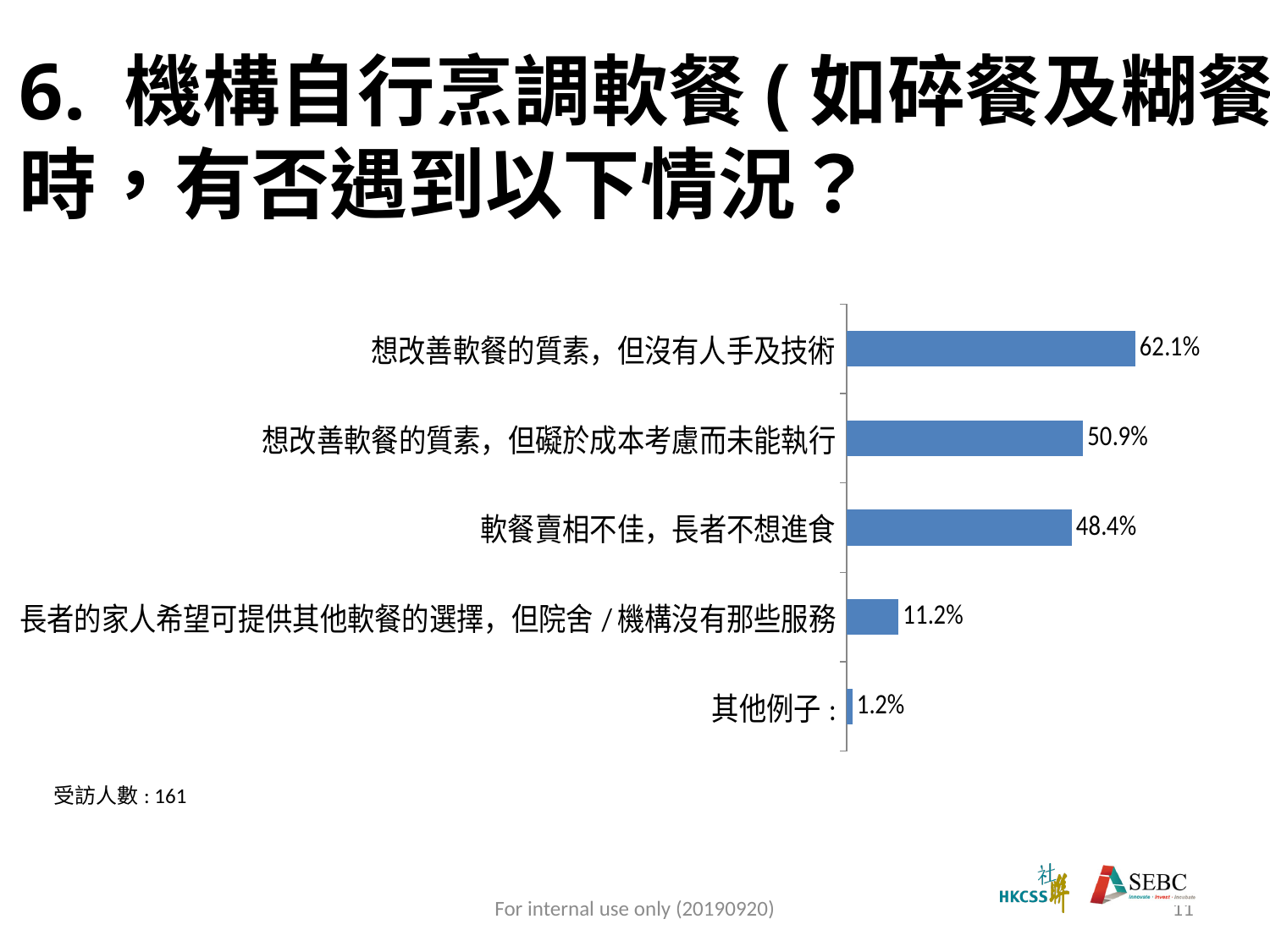
Which category has the lowest value? 其他例子 What kind of chart is shown on the slide? Bar chart What is the difference between the values for 想改善軟餐的質素，但沒有人手及技術 and 想改善軟餐的質素，但礙於成本考慮而未能執行? 11.2% What is the difference between the values for 想改善軟餐的質素，但礙於成本考慮而未能執行 and 軟餐賣相不佳，長者不想進食? 2.5% How many respondents (受訪人數) are noted below the chart? 161 What is the value for 想改善軟餐的質素，但沒有人手及技術? 62.1% How many categories are shown in the chart? 5 What is the value for 長者的家人希望可提供其他軟餐的選擇，但院舍／機構沒有那些服務? 11.2% What is the value for 軟餐賣相不佳，長者不想進食? 48.4% What is the value for 其他例子? 1.2% Which category has the highest value? 想改善軟餐的質素，但沒有人手及技術 Which is larger: the value for 軟餐賣相不佳，長者不想進食 or the value for 長者的家人希望可提供其他軟餐的選擇，但院舍／機構沒有那些服務? 軟餐賣相不佳，長者不想進食